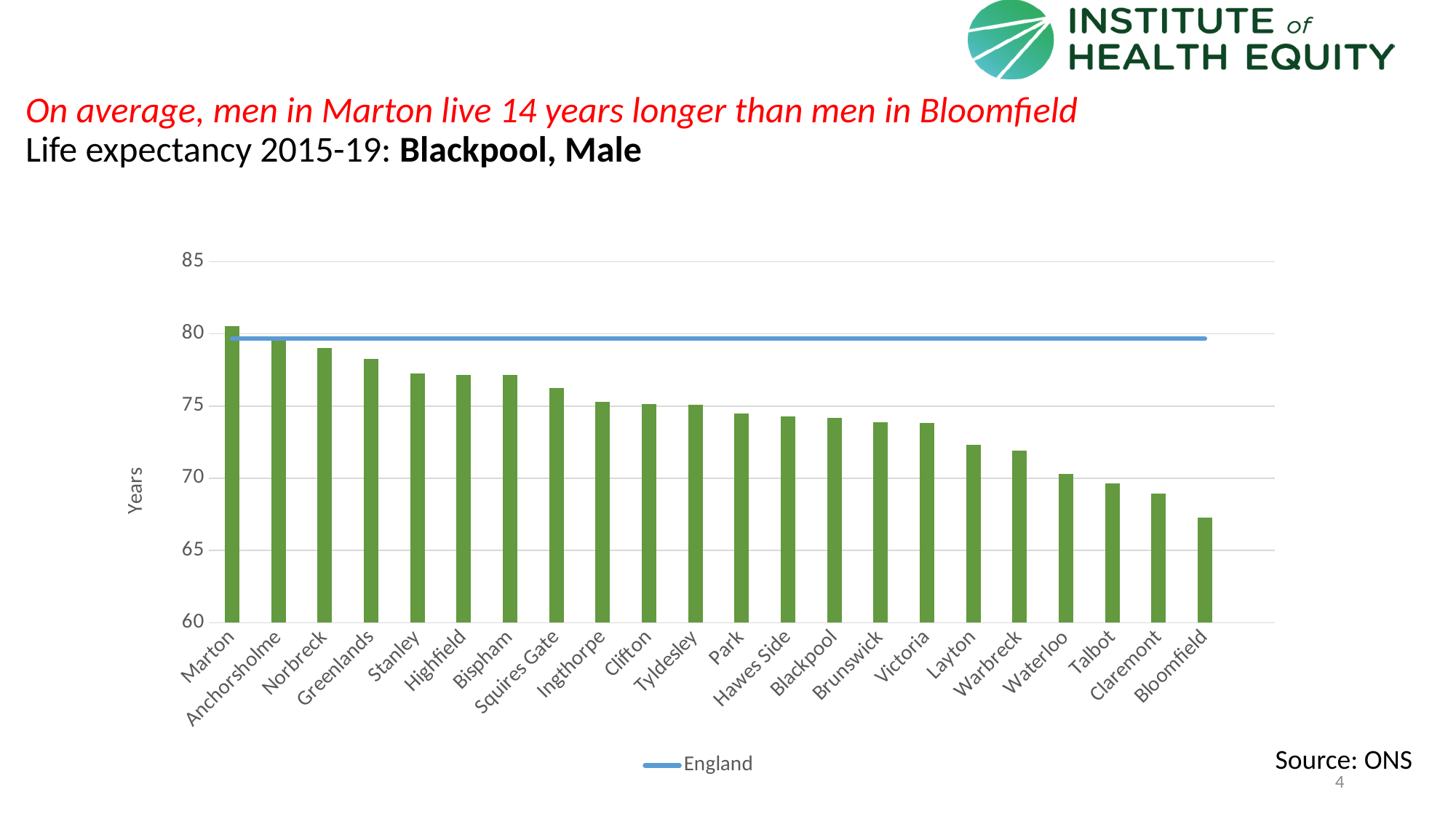
Which ward has the highest male life expectancy in the chart? Marton What is the label on the vertical axis of the chart? Years How many entries does the chart legend list? 1 What does the blue horizontal line in the chart represent, according to the legend? England Do the bar values rise or fall from left to right along the x axis? Fall Which has the larger value, Norbreck or Greenlands? Norbreck Is the value for Bloomfield greater or less than 70? less Which ward has the lowest male life expectancy in the chart? Bloomfield Is the value for Stanley greater or less than 75? greater What kind of chart is shown on the slide? Bar chart How many wards (bars) are shown in the chart? 22 Is the value for Layton greater or less than 70? greater